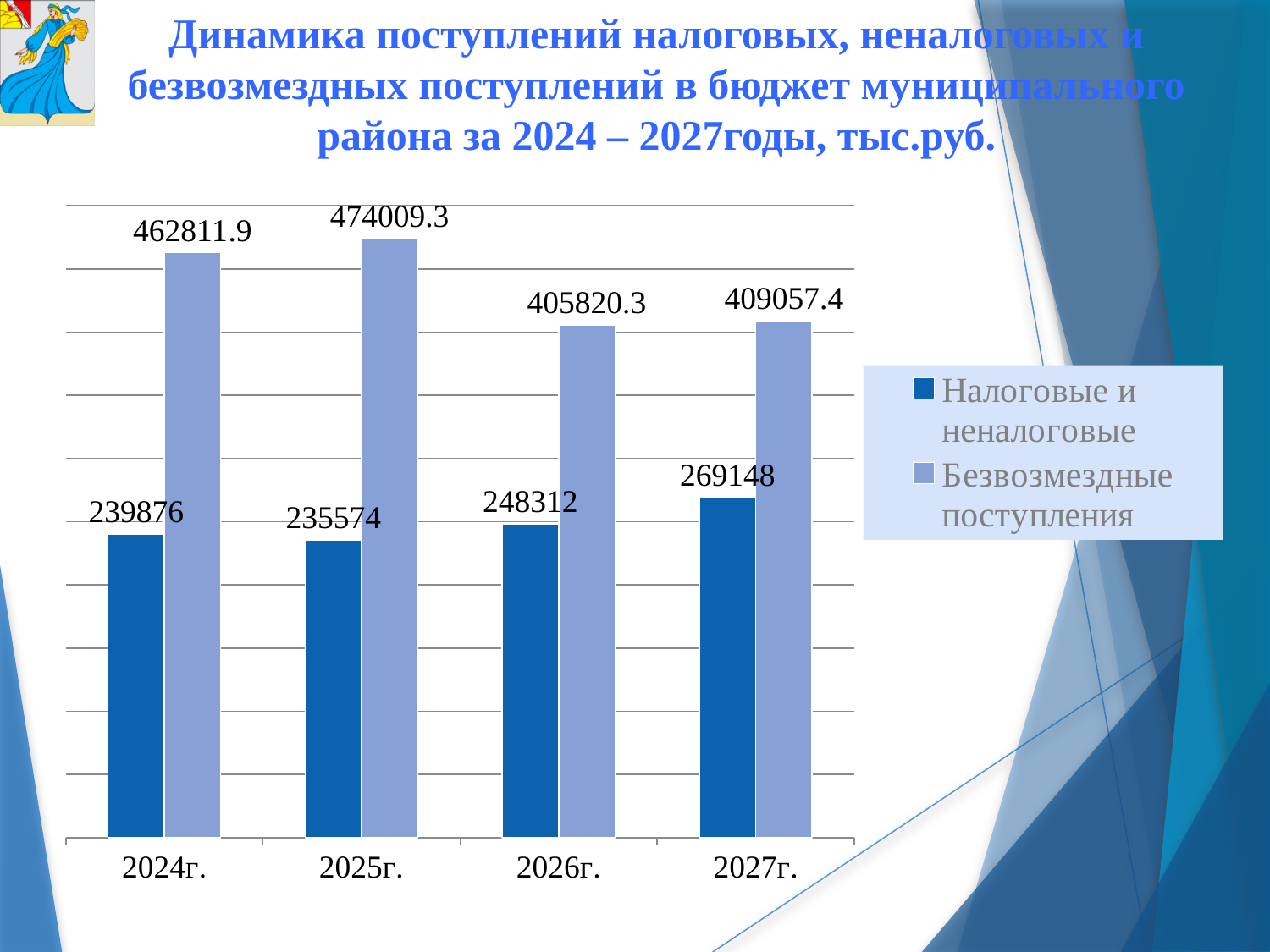
What is the difference between the Налоговые и неналоговые values for 2027г. and 2026г.? 20836 What is the value for Налоговые и неналоговые in 2027г.? 269148 What is the value for Налоговые и неналоговые in 2024г.? 239876 How many series does the legend list? 2 In which year is the value for Налоговые и неналоговые lowest? 2025г. Which is larger in 2026г.: Налоговые и неналоговые or Безвозмездные поступления? Безвозмездные поступления What kind of chart is shown on the slide? Bar chart What is the value for Безвозмездные поступления in 2026г.? 405820.3 In which year is the value for Безвозмездные поступления highest? 2025г. How many years are shown on the x axis? 4 What is the difference between the Безвозмездные поступления values for 2025г. and 2024г.? 11197.4 What is the value for Безвозмездные поступления in 2025г.? 474009.3